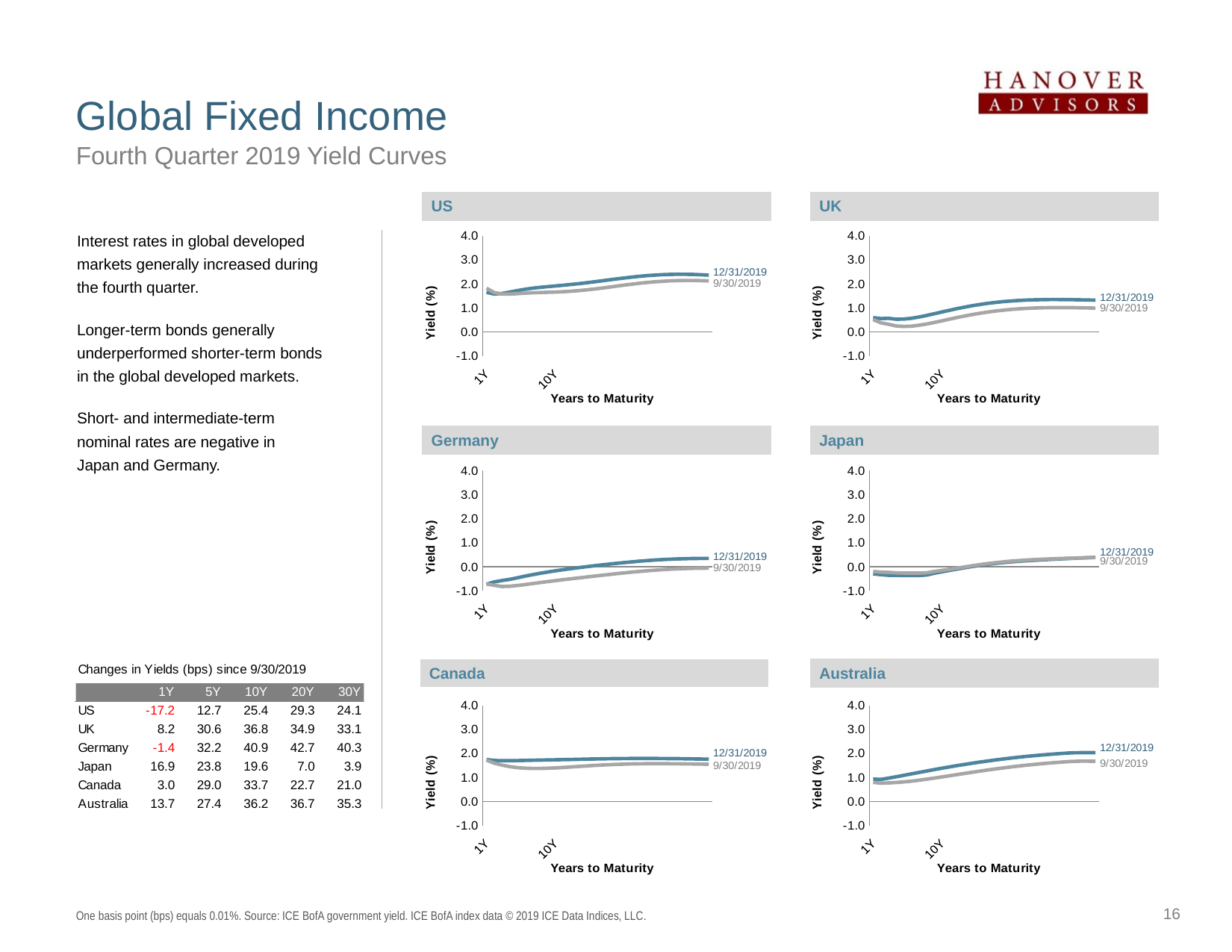
What kind of chart is the US chart? line chart In the Canada chart, is the 12/31/2019 value at 1Y greater or less than 1.0? greater In the Germany chart, is the 12/31/2019 value at 1Y greater or less than 0.0? less In the Germany chart, does the 12/31/2019 series rise or fall from 1Y to 10Y? rise In the Japan chart, is the 9/30/2019 value at 1Y greater or less than 1.0? less How many yield curve charts are shown on the slide? 6 In the Australia chart, which series is higher at 10Y, 12/31/2019 or 9/30/2019? 12/31/2019 What is the y-axis label on the Japan chart? Yield (%)